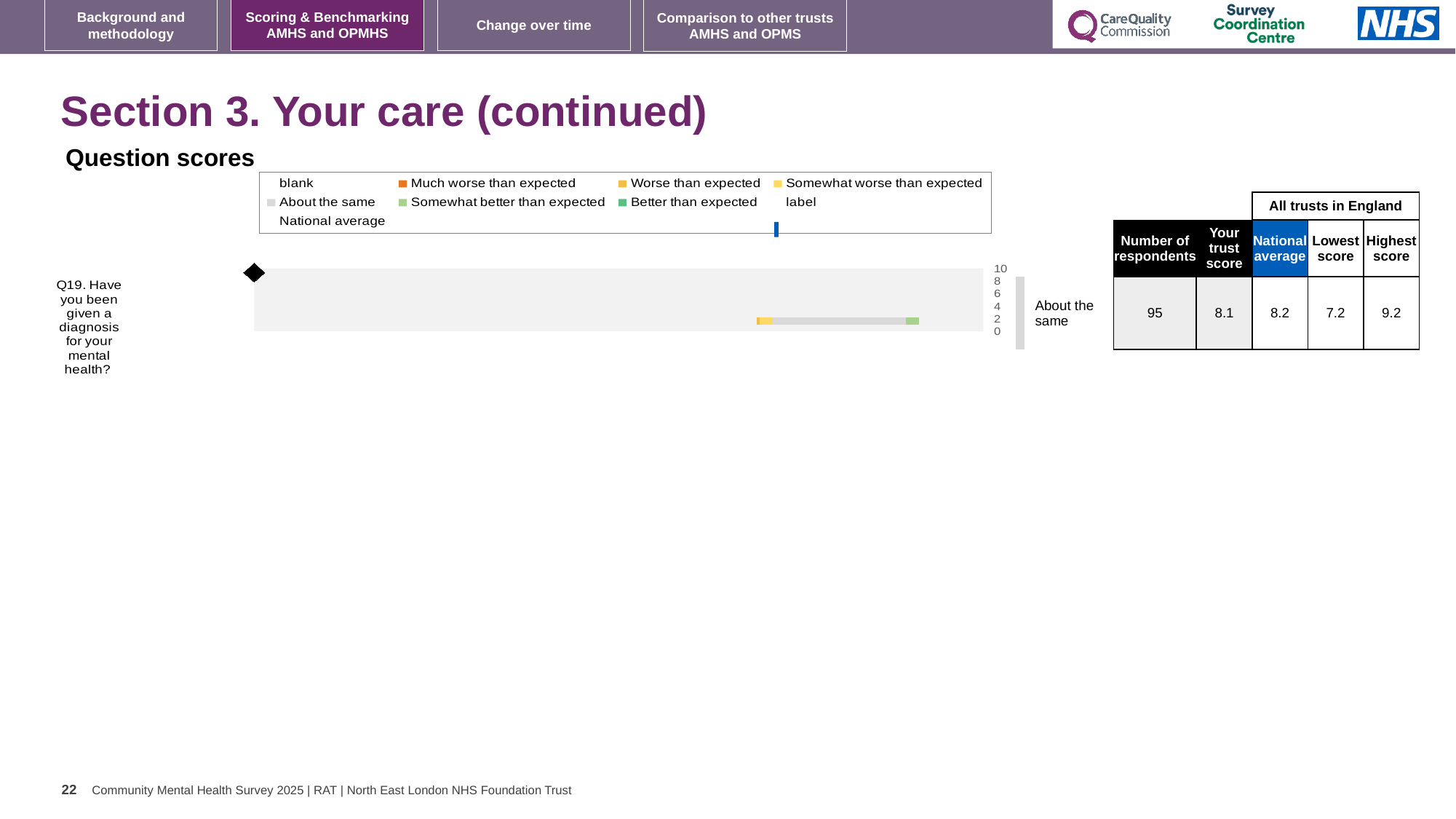
What is the difference between the highest score and the lowest score for Q19 among all trusts in England? 2.0 What is the heading shown directly above the chart? Question scores What kind of chart is used to show the Q19 question score? bar chart What is the national average for Q19 shown in the table beside the chart? 8.2 What is the lowest score among all trusts in England for Q19? 7.2 How many entries does the legend of the Question scores chart list? 9 How many survey questions are plotted in the Question scores chart? 1 What benchmark category is shown for Q19 (Have you been given a diagnosis for your mental health?)? About the same What colour represents 'Much worse than expected' in the chart legend? orange Which is larger for Q19, the trust score or the national average? National average What is the trust score for Q19 shown in the table beside the chart? 8.1 How many respondents answered Q19 according to the table beside the chart? 95